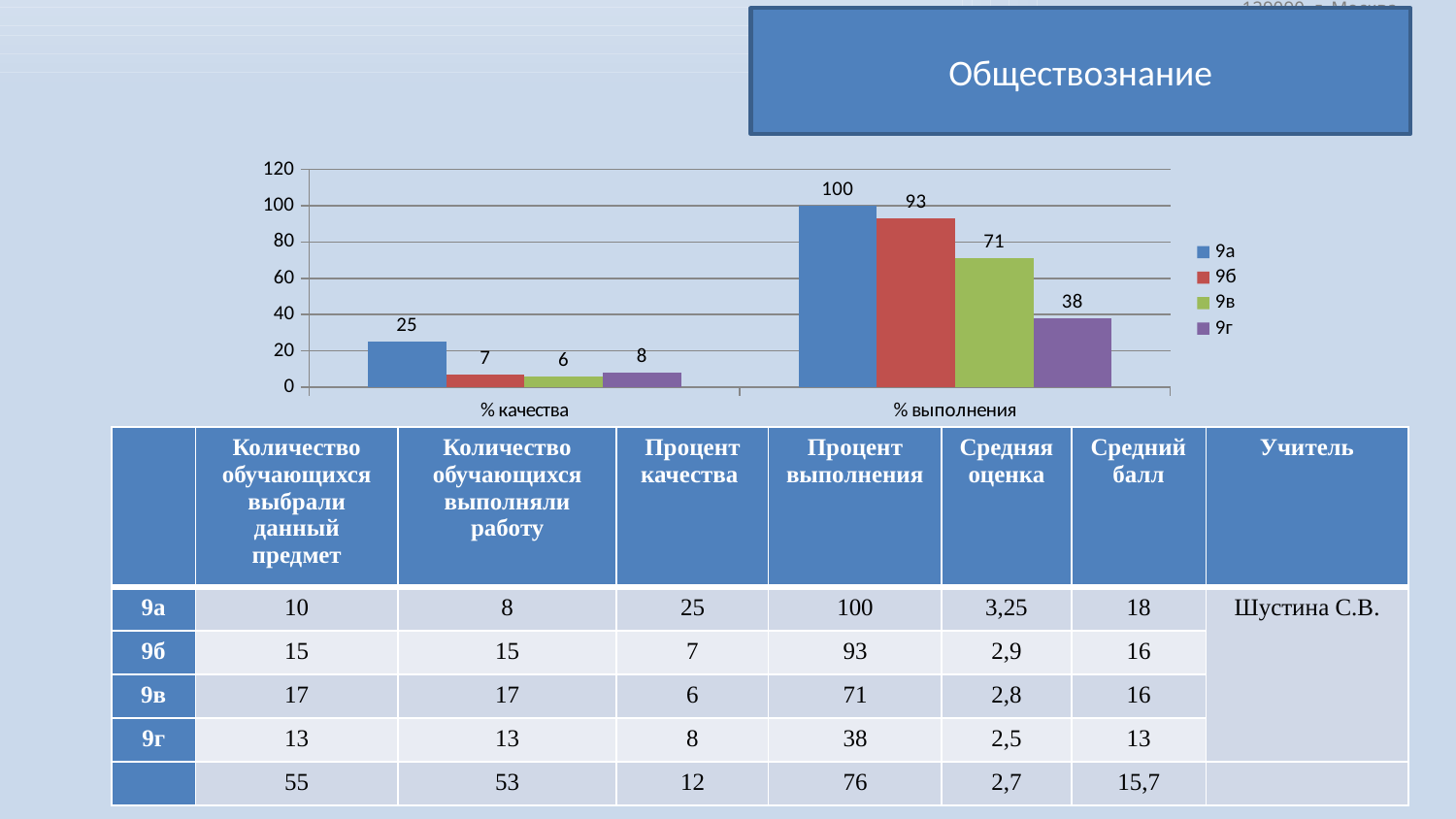
How many series does the chart legend list? 4 What is the difference between the 9а and 9г values in the % выполнения category? 62 What is the value for 9а in the % качества category? 25 What type of chart is shown on the slide? bar chart What is the maximum value shown on the chart's vertical axis? 120 What is the value for 9б in the % выполнения category? 93 Which is larger in the % качества category: the value for 9б or the value for 9г? 9г Which series has the highest value in the % выполнения category? 9а Is the value for 9в in the % выполнения category greater or less than 60? greater What is the value for 9г in the % выполнения category? 38 How many categories are shown on the x axis of the chart? 2 Which series has the lowest value in the % качества category? 9в